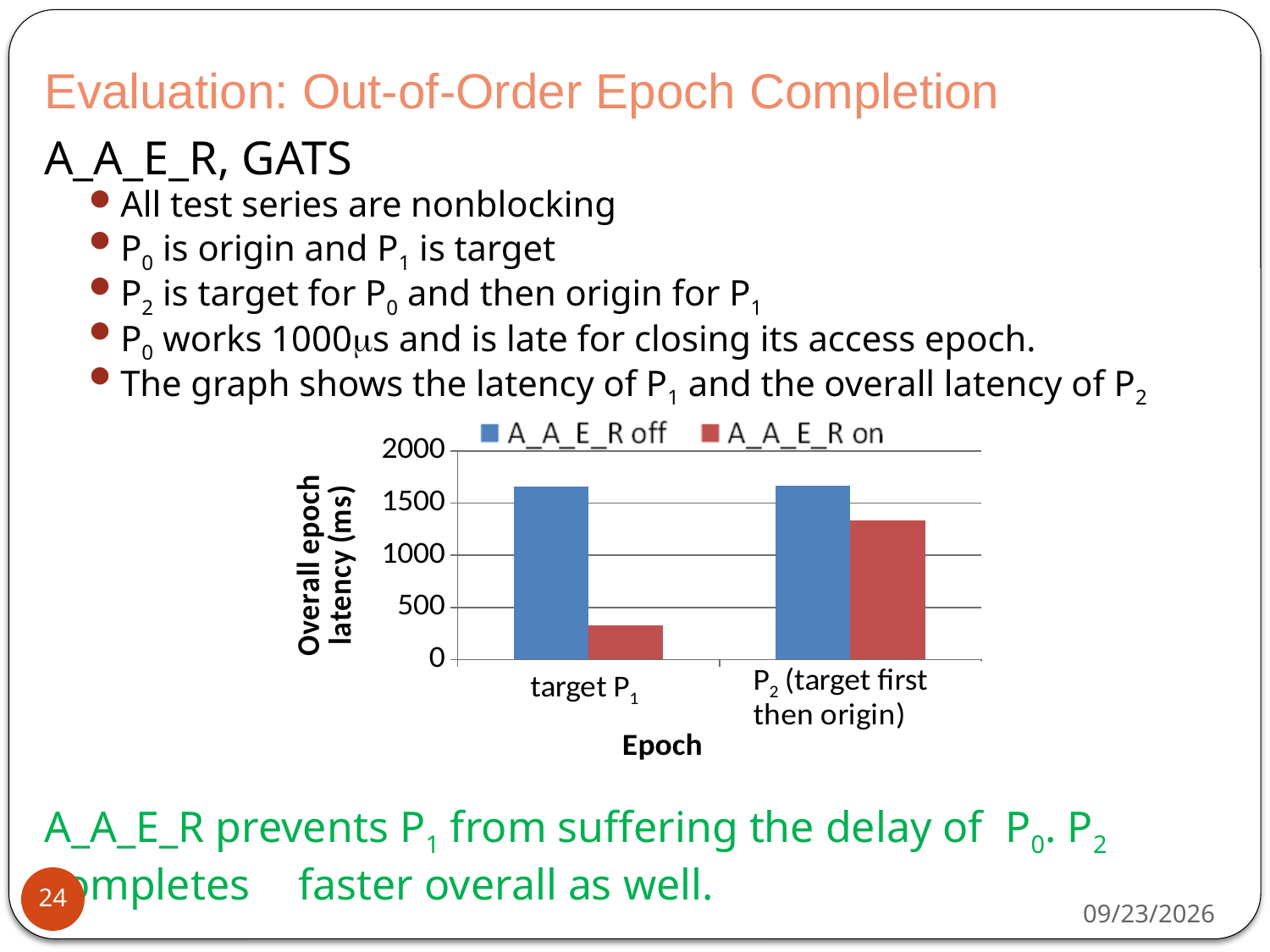
What kind of chart is shown on the slide? bar chart Is the A_A_E_R on value for P2 (target first then origin) greater or less than 1500? less For P2 (target first then origin), which series has the larger value, A_A_E_R off or A_A_E_R on? A_A_E_R off How many categories are shown on the x axis of the chart? 2 Is the A_A_E_R off value for target P1 greater or less than 1500? greater Within the A_A_E_R on series, which category has the lower value? target P1 What is the label of the y axis of the chart? Overall epoch latency (ms) Is the A_A_E_R on value for target P1 greater or less than 500? less For target P1, which series has the larger value, A_A_E_R off or A_A_E_R on? A_A_E_R off Which colour represents the A_A_E_R on series in the chart? red How many series does the chart legend list? 2